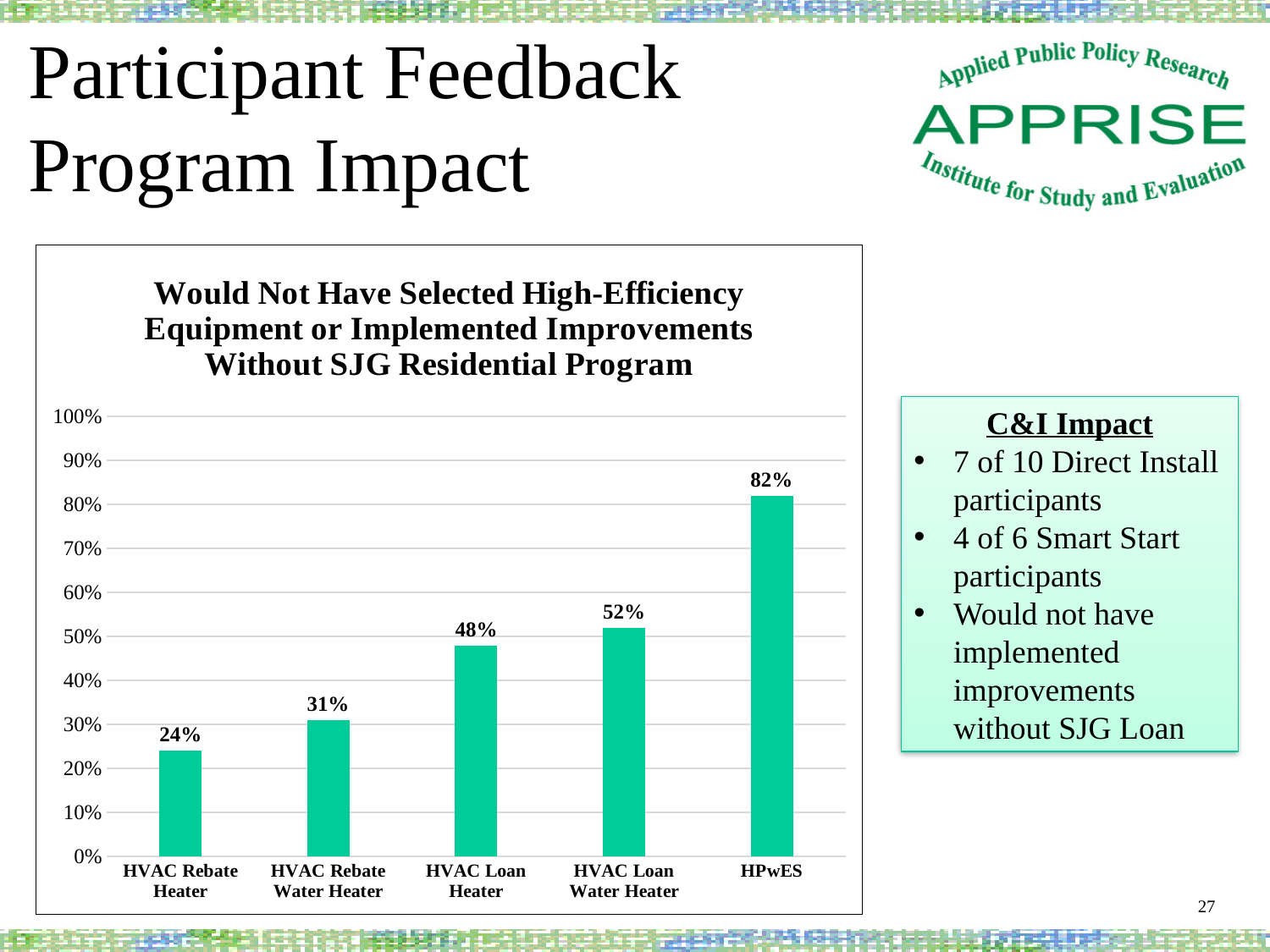
Which is larger, the value for HVAC Loan Heater or HVAC Rebate Water Heater? HVAC Loan Heater Which category has the lowest value? HVAC Rebate Heater What is the difference between the values for HVAC Rebate Water Heater and HVAC Rebate Heater? 7% What is the value for HPwES? 82% How many categories are shown on the x axis? 5 What kind of chart is shown? bar chart What is the value for HVAC Loan Water Heater? 52% What is the value for HVAC Rebate Heater? 24% Is the value for HVAC Loan Heater greater or less than 40%? greater What is the difference between the values for HPwES and HVAC Loan Water Heater? 30% Which category has the highest value? HPwES Do the values rise or fall from left to right along the x axis? rise